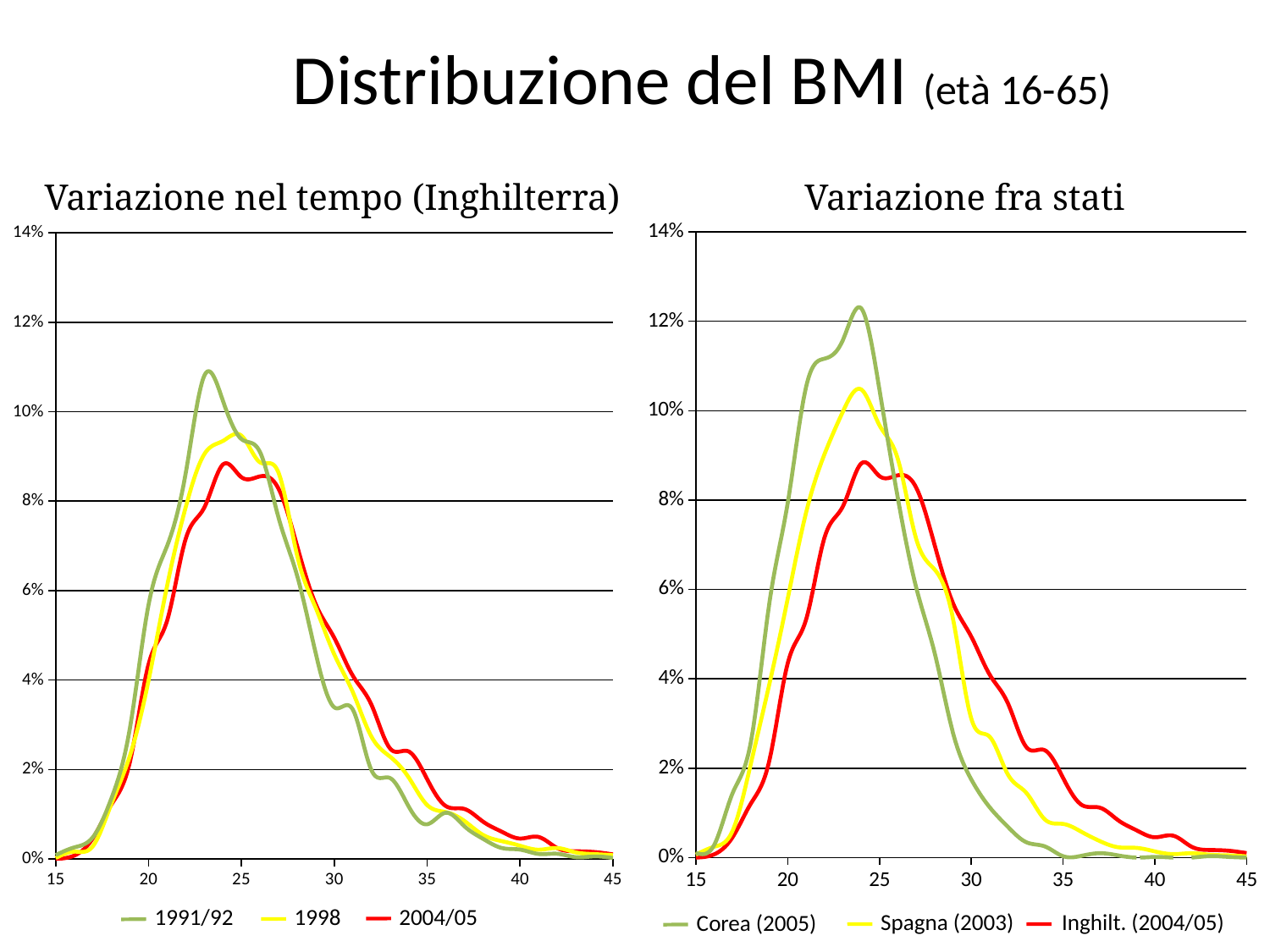
How many series does the legend of the left chart 'Variazione nel tempo (Inghilterra)' list? 3 In the right chart 'Variazione fra stati', which series reaches the highest peak? Corea (2005) How many series does the legend of the right chart 'Variazione fra stati' list? 3 What are the names of the series listed in the legend of the right chart 'Variazione fra stati'? Corea (2005), Spagna (2003), Inghilt. (2004/05) What kind of chart is the left chart titled 'Variazione nel tempo (Inghilterra)'? line chart In the right chart 'Variazione fra stati', which series has the higher peak, Corea (2005) or Inghilt. (2004/05)? Corea (2005) In the right chart 'Variazione fra stati', which series has the lowest peak? Inghilt. (2004/05) What kind of chart is the right chart titled 'Variazione fra stati'? line chart In the left chart 'Variazione nel tempo (Inghilterra)', is the peak value for 2004/05 greater or less than 10%? less In the right chart 'Variazione fra stati', is the peak value for Spagna (2003) greater or less than 10%? greater In the left chart 'Variazione nel tempo (Inghilterra)', which series reaches the highest peak? 1991/92 In the right chart 'Variazione fra stati', do the values for Corea (2005) rise or fall as BMI goes from 30 to 40? fall